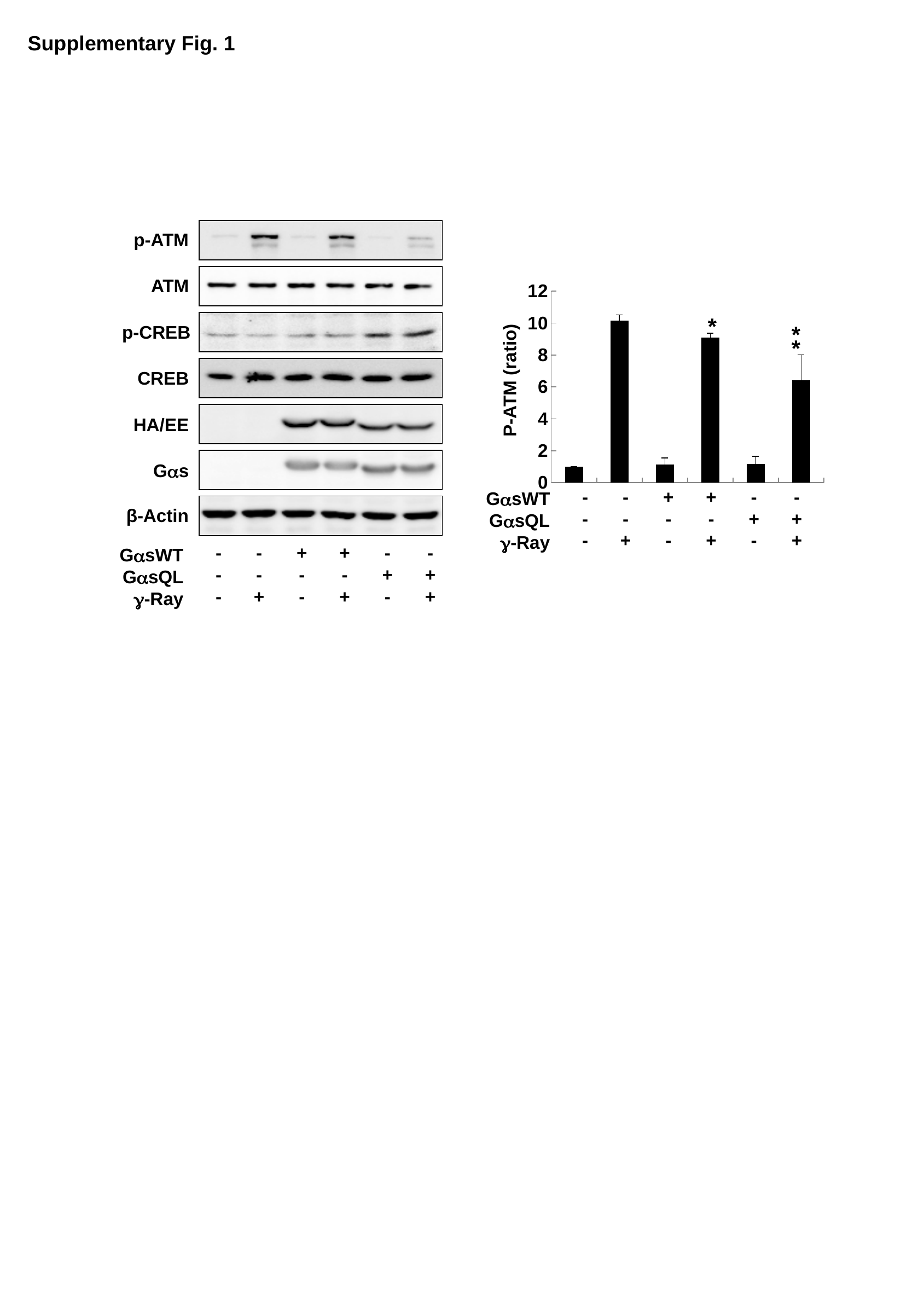
In the P-ATM (ratio) bar chart, is the value for the sixth bar (GαsQL +, γ-Ray +) greater or less than 8? less In the P-ATM (ratio) bar chart, which bar is the highest? the second bar (GαsWT -, GαsQL -, γ-Ray +) What kind of chart is shown on the right side of the slide? bar chart In the P-ATM (ratio) bar chart, is the value for the sixth bar (GαsQL +, γ-Ray +) greater or less than 4? greater In the P-ATM (ratio) bar chart, is the value for the second bar (γ-Ray + only) greater or less than 8? greater In the P-ATM (ratio) bar chart, which is larger: the fourth bar (GαsWT +, γ-Ray +) or the sixth bar (GαsQL +, γ-Ray +)? the fourth bar (GαsWT +, γ-Ray +) How many bars does the P-ATM (ratio) bar chart contain? 6 What is the y-axis label of the bar chart? P-ATM (ratio) What is the highest tick value shown on the y-axis of the bar chart? 12 In the P-ATM (ratio) bar chart, which is larger: the second bar (γ-Ray + only) or the sixth bar (GαsQL +, γ-Ray +)? the second bar (γ-Ray + only)